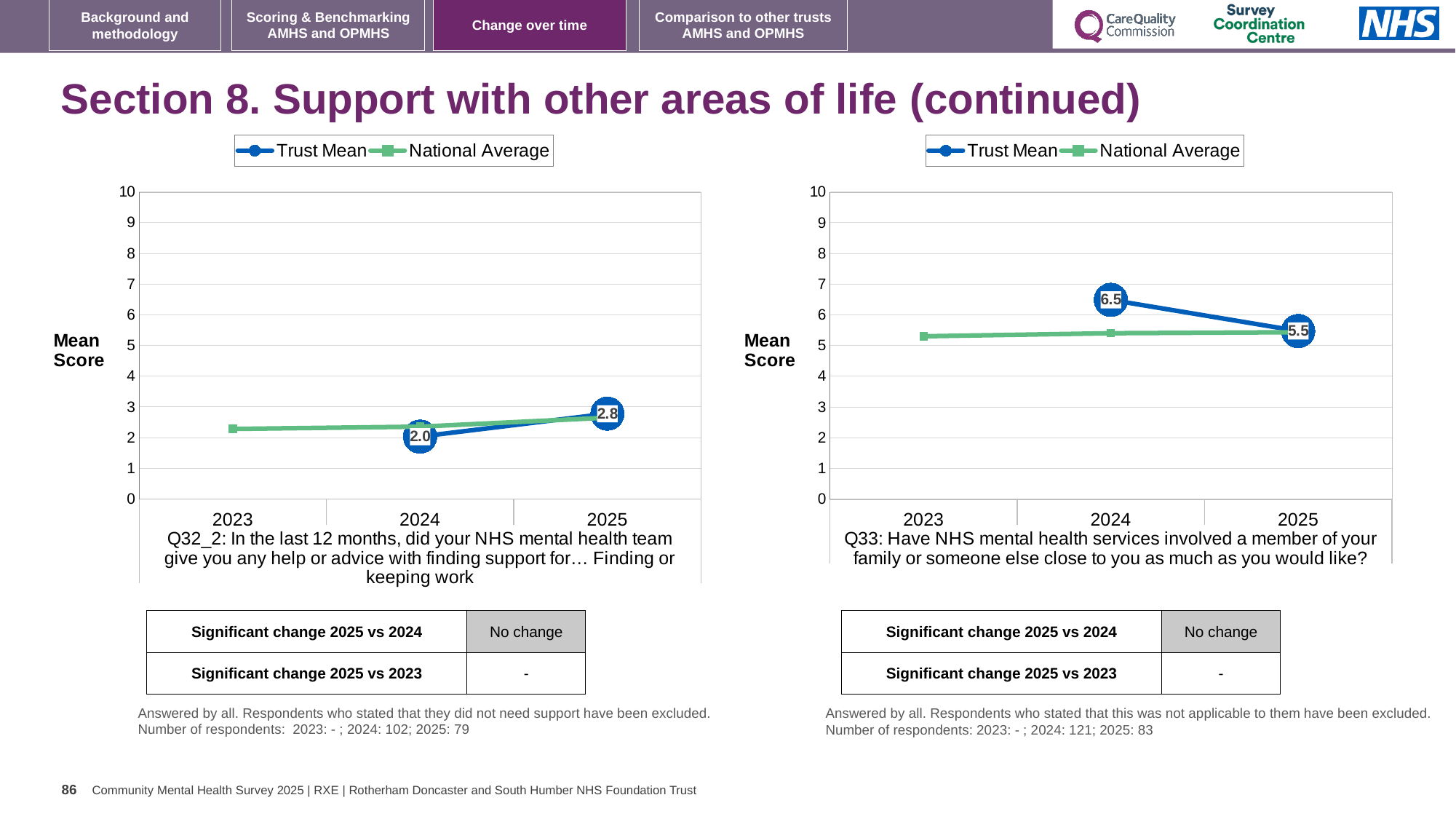
What type of chart is used on the left side of the slide (Q32_2)? line chart On the left chart (Q32_2), by how much did the Trust Mean change from 2024 to 2025? 0.8 On the left chart (Q32_2), does the Trust Mean rise or fall from 2024 to 2025? rise On the right chart (Q33), what is the difference between the Trust Mean in 2024 and in 2025? 1.0 How many series does the legend of the right chart (Q33) list? 2 On the left chart (Q32_2), what is the Trust Mean value for 2024? 2.0 On the right chart (Q33), does the Trust Mean rise or fall from 2024 to 2025? fall On the right chart (Q33), is the National Average value for 2023 greater or less than 6? less On the right chart (Q33), what is the Trust Mean value for 2025? 5.5 On the right chart (Q33), which is larger in 2024: the Trust Mean or the National Average? Trust Mean On the right chart (Q33), what is the Trust Mean value for 2024? 6.5 On the left chart (Q32_2), what is the Trust Mean value for 2025? 2.8